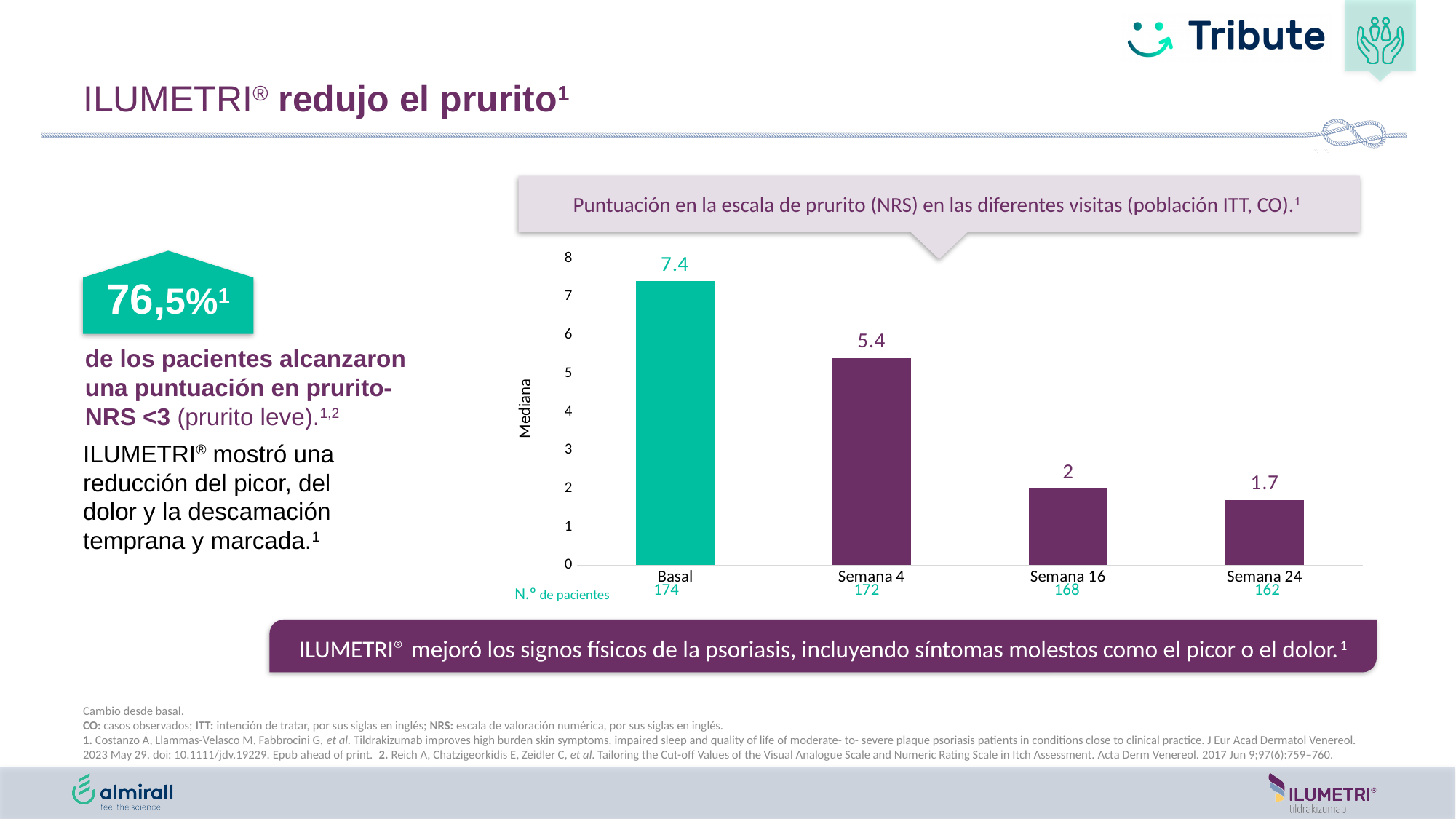
What is the median pruritus NRS score at Semana 16? 2 Which visit has the highest median pruritus score? Basal What is the difference between the median score at Basal and at Semana 24? 5.7 Which is larger, the median score at Semana 4 or at Semana 16? Semana 4 What is the difference between the median score at Semana 4 and at Semana 16? 3.4 What kind of chart is used to show the pruritus scores? Bar chart Which visit has the lowest median pruritus score? Semana 24 What is the median pruritus NRS score at Semana 24? 1.7 How many visits are shown on the x axis of the chart? 4 Do the median pruritus scores rise or fall from Basal to Semana 24? Fall What is the median pruritus NRS score at Basal? 7.4 What is the median pruritus NRS score at Semana 4? 5.4